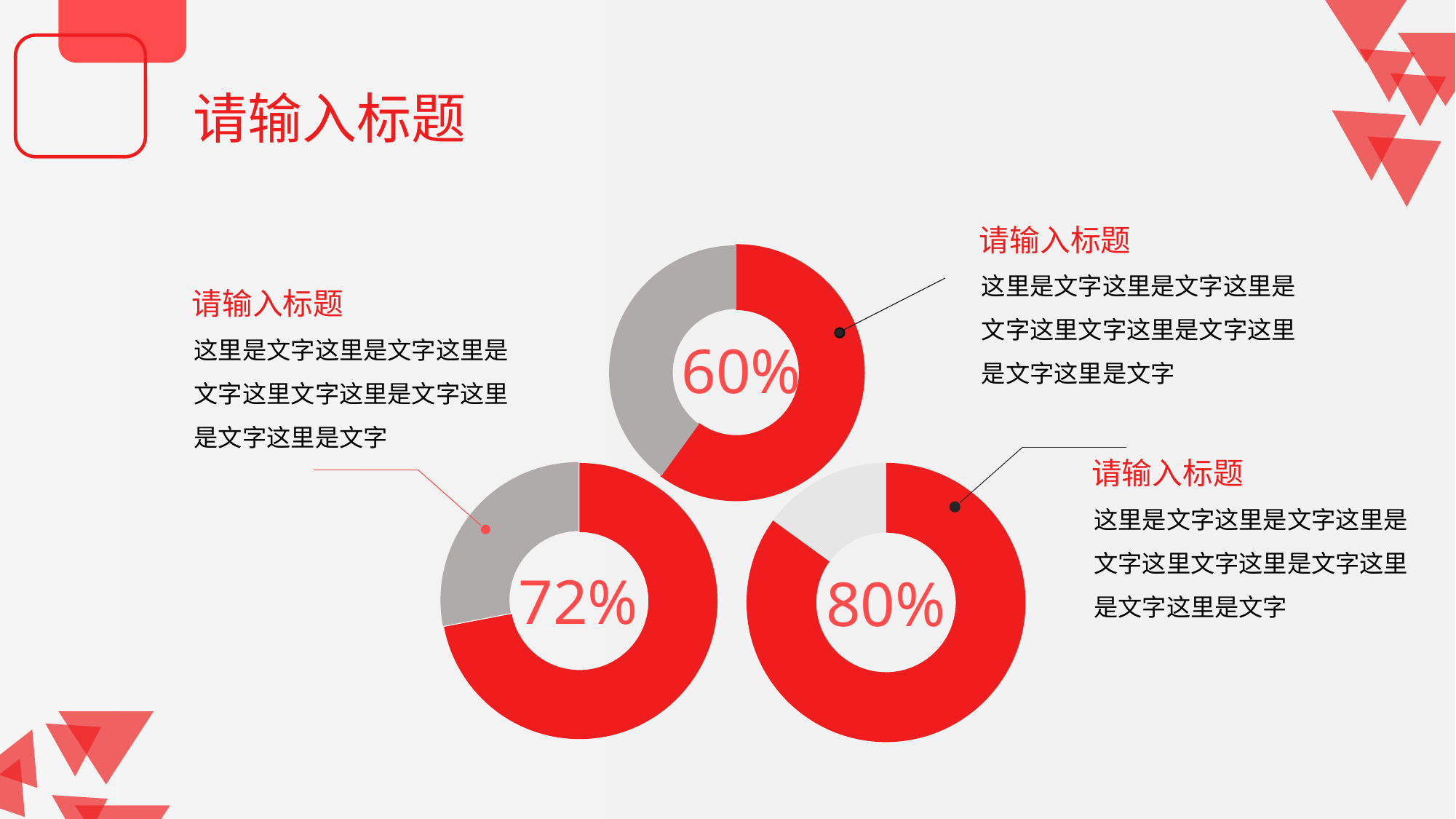
Which is larger, the percentage in the bottom-left donut or the percentage in the top donut? The bottom-left donut (72%) In the top donut chart, what share of the ring is filled in red? 60% How many donut charts are on the slide? 3 What is the difference between the percentage in the bottom-right donut and the percentage in the top donut? 20% What is the difference between the percentage in the bottom-right donut and the percentage in the bottom-left donut? 8% What percentage is shown in the centre of the top donut chart? 60% Which of the three donut charts shows the highest percentage? The bottom-right donut (80%) What percentage is shown in the centre of the bottom-left donut chart? 72% What kind of chart is used to display the percentages on this slide? Donut chart Which of the three donut charts shows the lowest percentage? The top donut (60%) What colour is used for the filled (completed) portion of each donut chart? Red What percentage is shown in the centre of the bottom-right donut chart? 80%